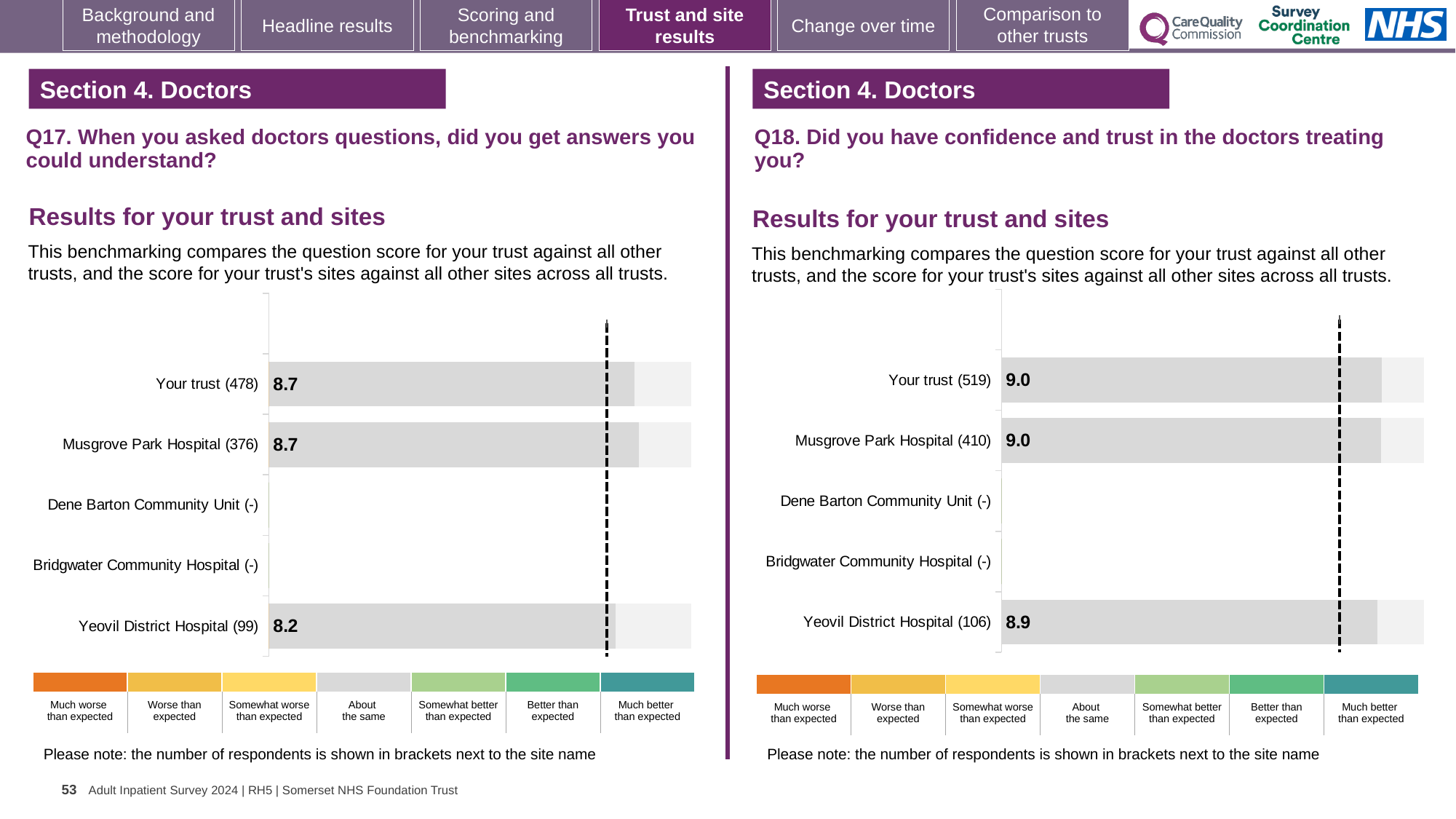
On the Q17 chart (left), how many respondents are shown for Musgrove Park Hospital? 376 On the Q17 chart (left), how many sites or rows are listed on the vertical axis? 5 What type of chart is used on the Q18 chart (right)? Bar chart On the Q18 chart (right), what is the difference between the Your trust score and the Yeovil District Hospital score? 0.1 On the Q17 chart (left), what is the score for Your trust? 8.7 On the Q18 chart (right), what is the score for Musgrove Park Hospital? 9.0 On the Q18 chart (right), how many respondents are shown for Your trust? 519 On the Q17 chart (left), what is the score for Yeovil District Hospital? 8.2 On the Q18 chart (right), what is the score for Yeovil District Hospital? 8.9 On the Q17 chart (left), which site has the lowest score? Yeovil District Hospital On the Q17 chart (left), what is the difference between the Musgrove Park Hospital score and the Yeovil District Hospital score? 0.5 On the Q17 chart (left), which is larger: the score for Your trust or the score for Yeovil District Hospital? Your trust